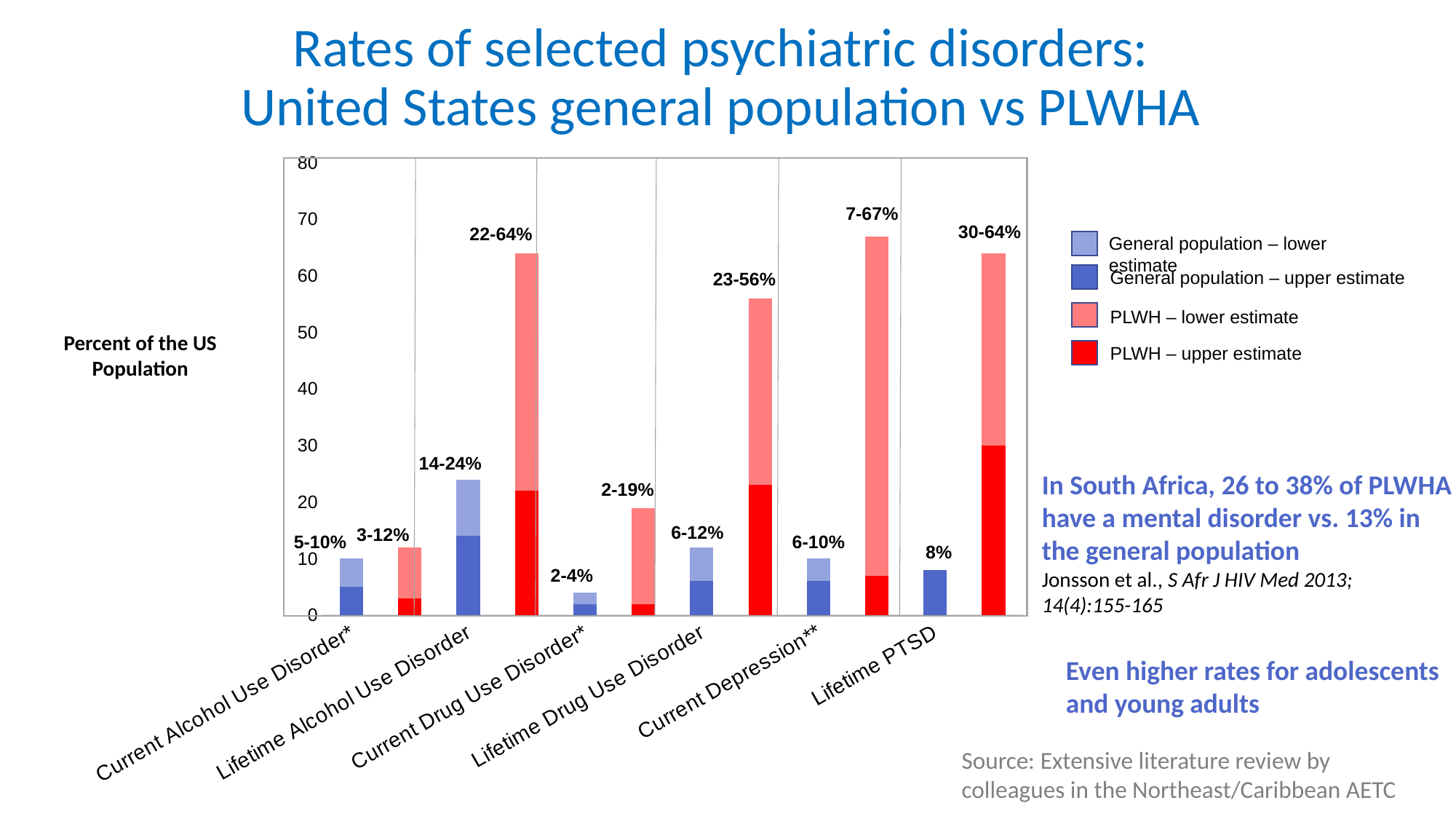
What value is labelled for the general population for Lifetime PTSD? 8% How many series does the legend list? 4 What range is labelled for the general population for Lifetime Alcohol Use Disorder? 14-24% How many disorder categories are shown on the x axis? 6 What is the label on the vertical axis of the chart? Percent of the US Population What range is labelled for PLWH for Current Depression**? 7-67% Which category has the lowest general population upper estimate? Current Drug Use Disorder* What kind of chart is shown on the slide? Bar chart What range is labelled for PLWH for Lifetime PTSD? 30-64% Which has the larger PLWH upper estimate: Lifetime Alcohol Use Disorder or Current Depression**? Current Depression** For Lifetime PTSD, how much higher is the PLWH upper estimate (64%) than the general population value (8%)? 56 percentage points Which category has the highest PLWH upper estimate? Current Depression**